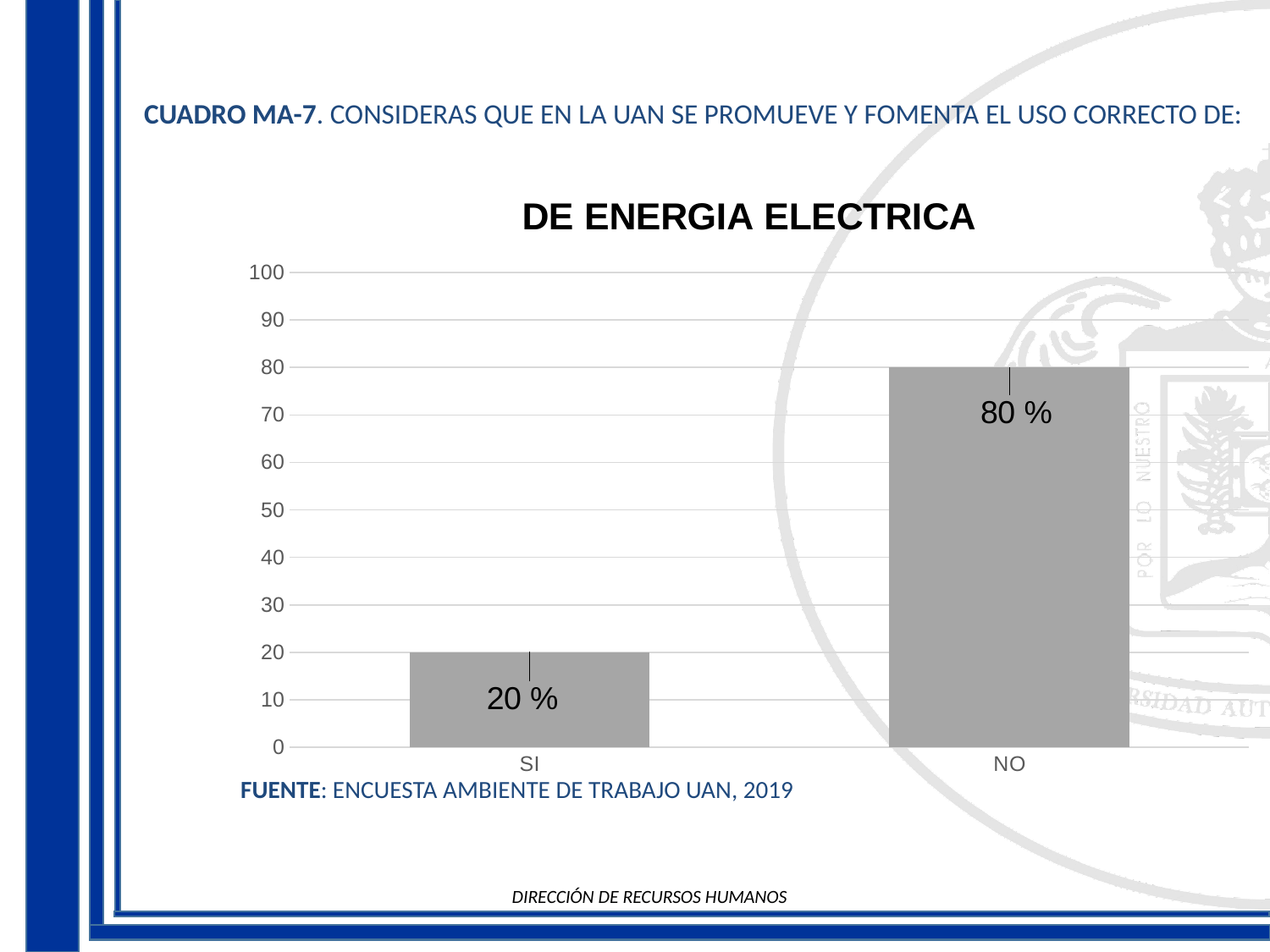
Is the value for NO greater or less than 50? greater What is the value for SI? 20 % What is the difference between the values for NO and SI? 60 % Is the value for SI greater or less than 30? less Which category has the lowest value? SI Which category has the highest value? NO What is the title of the chart? DE ENERGIA ELECTRICA What kind of chart is shown? bar chart How many categories are shown on the x axis? 2 What is the maximum value shown on the y axis? 100 Which is larger, the value for SI or the value for NO? NO What is the value for NO? 80 %